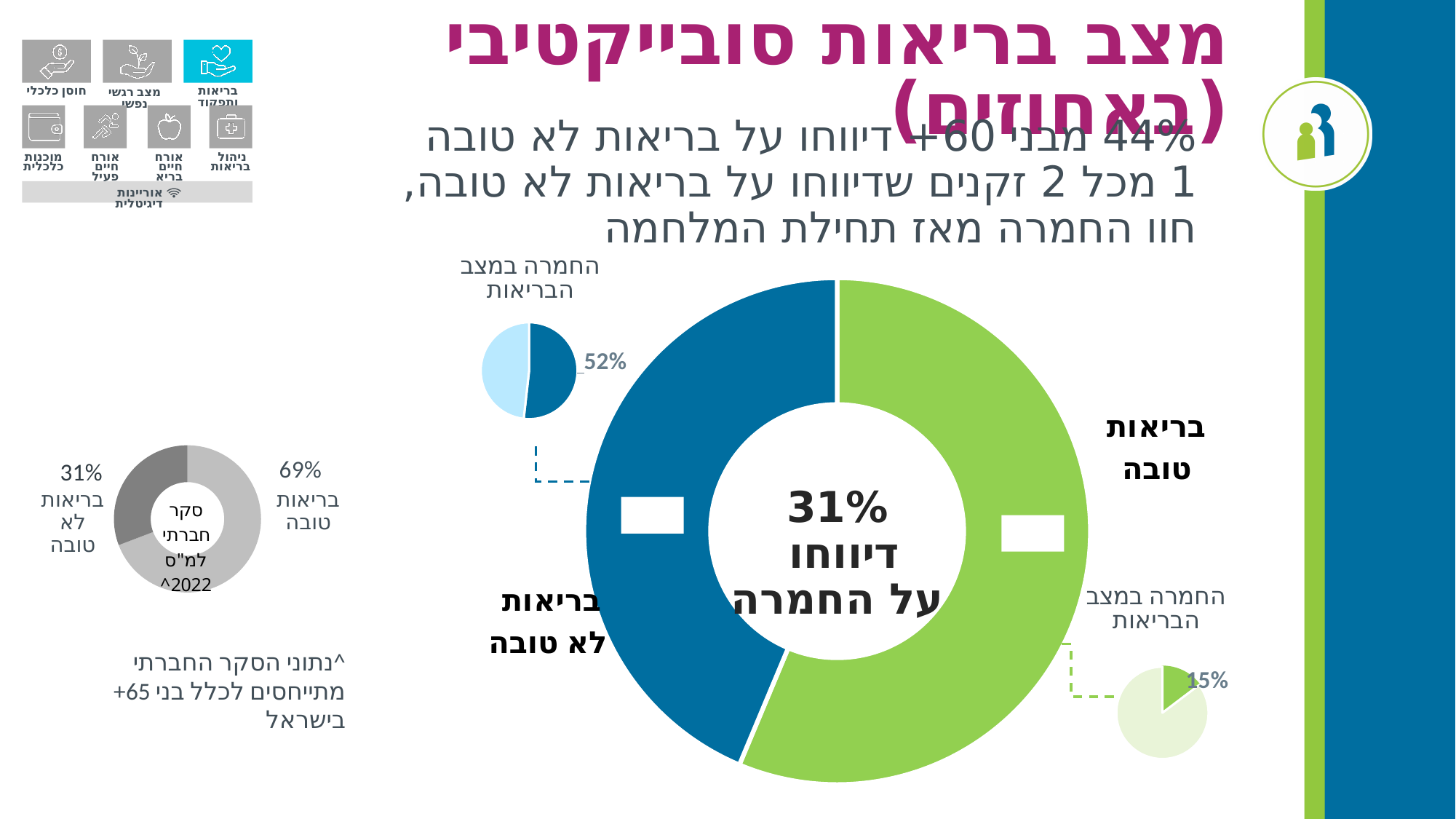
What colour is the בריאות טובה slice in the large donut chart in the centre? Green In the large donut chart in the centre, what percentage is printed in the middle of the chart? 31% In the large donut chart in the centre, which slice is larger: בריאות טובה or בריאות לא טובה? בריאות טובה In the small donut chart on the left (סקר חברתי למ"ס 2022), what is the value for בריאות טובה? 69% In the small donut chart on the left (סקר חברתי למ"ס 2022), what is the difference between בריאות טובה and בריאות לא טובה? 38% In the small donut chart on the left (סקר חברתי למ"ס 2022), which category is the largest? בריאות טובה In the small pie chart next to the בריאות טובה slice (החמרה במצב הבריאות), what value is labelled? 15% What kind of chart is the large chart in the centre of the slide? Donut (pie) chart In the small donut chart on the left (סקר חברתי למ"ס 2022), what is the value for בריאות לא טובה? 31% In the small pie chart next to the בריאות לא טובה slice (החמרה במצב הבריאות), what value is labelled? 52% Which of the two small pie charts labelled החמרה במצב הבריאות shows the larger value: the one next to בריאות לא טובה or the one next to בריאות טובה? The one next to בריאות לא טובה In the small donut chart on the left (סקר חברתי למ"ס 2022), how many categories are shown? 2